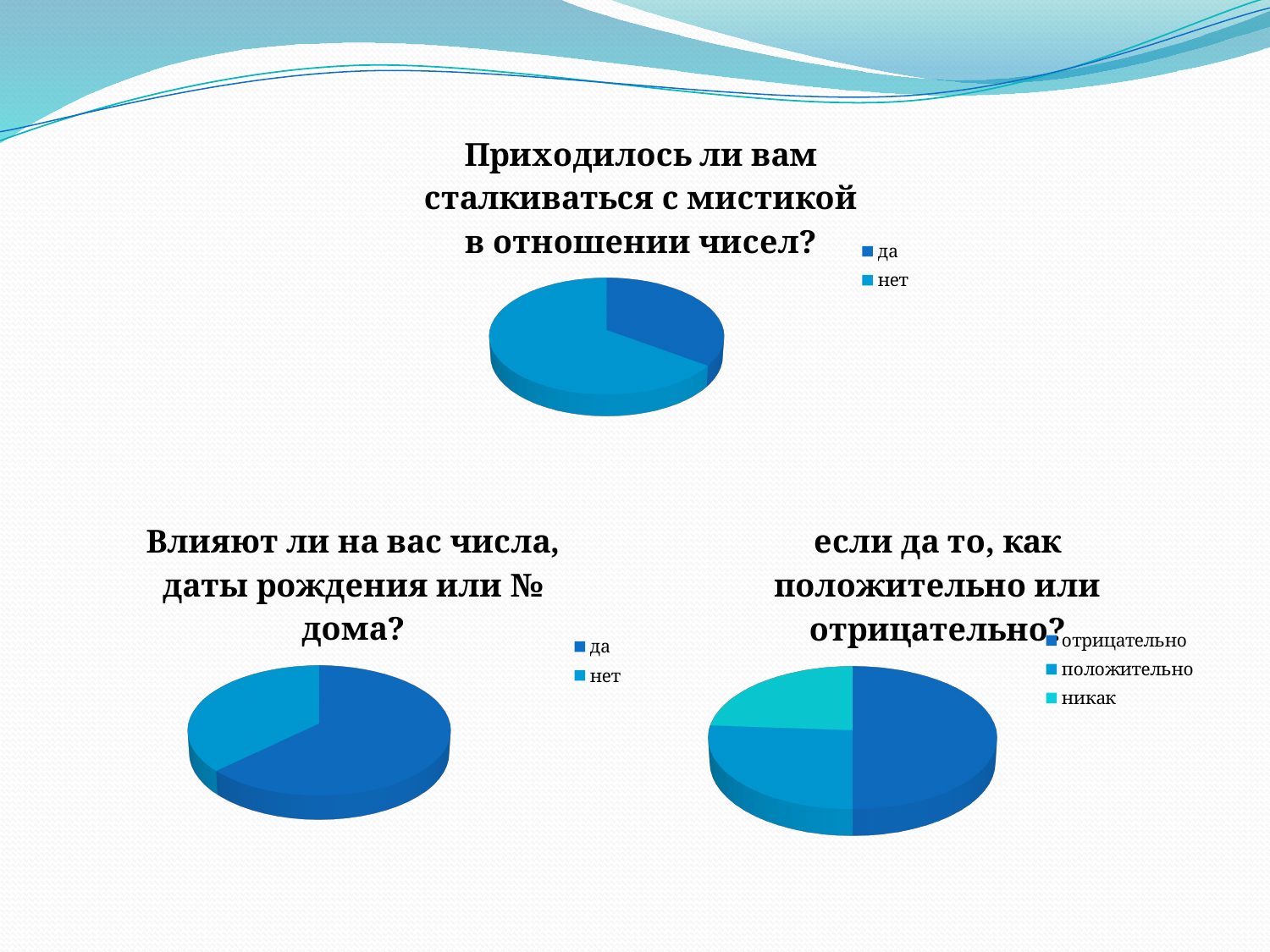
In the chart "Приходилось ли вам сталкиваться с мистикой в отношении чисел?", which is larger, the slice for да or the slice for нет? нет In the chart "Приходилось ли вам сталкиваться с мистикой в отношении чисел?", which answer has the largest slice? нет In the chart "если да то, как положительно или отрицательно?", how many categories does the legend list? 3 What kind of chart is used for "Приходилось ли вам сталкиваться с мистикой в отношении чисел?"? Pie chart In the chart "Влияют ли на вас числа, даты рождения или № дома?", which answer has the smallest slice? нет How many charts are shown on the slide? 3 In the chart "Влияют ли на вас числа, даты рождения или № дома?", which answer has the largest slice? да In the chart "Приходилось ли вам сталкиваться с мистикой в отношении чисел?", how many entries does the legend list? 2 What are the legend entries of the chart "если да то, как положительно или отрицательно?"? отрицательно, положительно, никак In the chart "если да то, как положительно или отрицательно?", which category has the largest slice? отрицательно